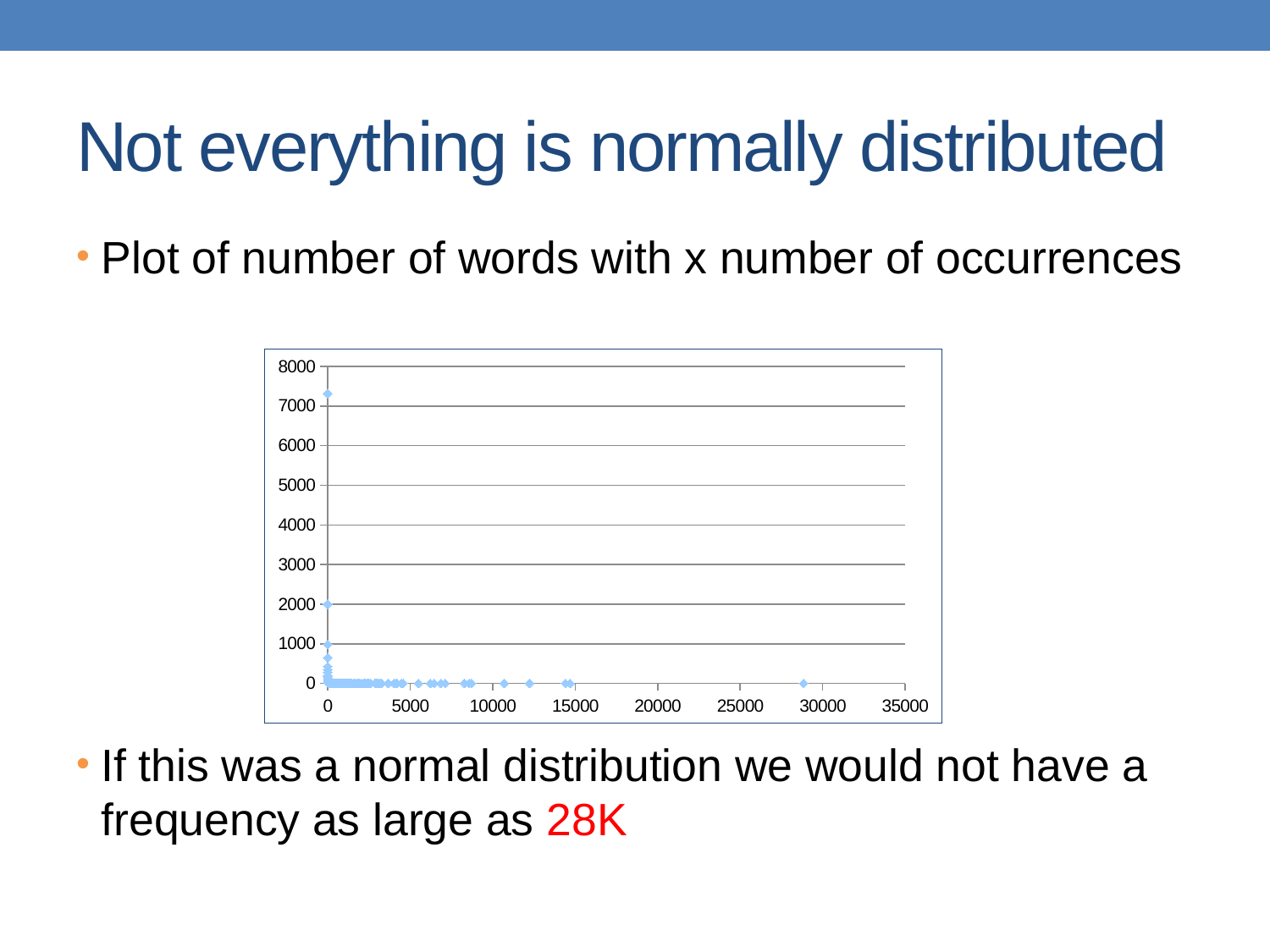
Do the plotted values generally rise or fall as the x value increases? fall Is the highest plotted value on the chart greater or less than 8000? less Is the highest plotted value on the chart greater or less than 7000? greater Is the x position of the rightmost point on the chart greater or less than 25000? greater What is the highest tick value shown on the y axis of the chart? 8000 What kind of chart is shown on the slide? scatter plot Are the points with the largest y values located near the left or the right end of the x axis? left What is the highest tick value shown on the x axis of the chart? 35000